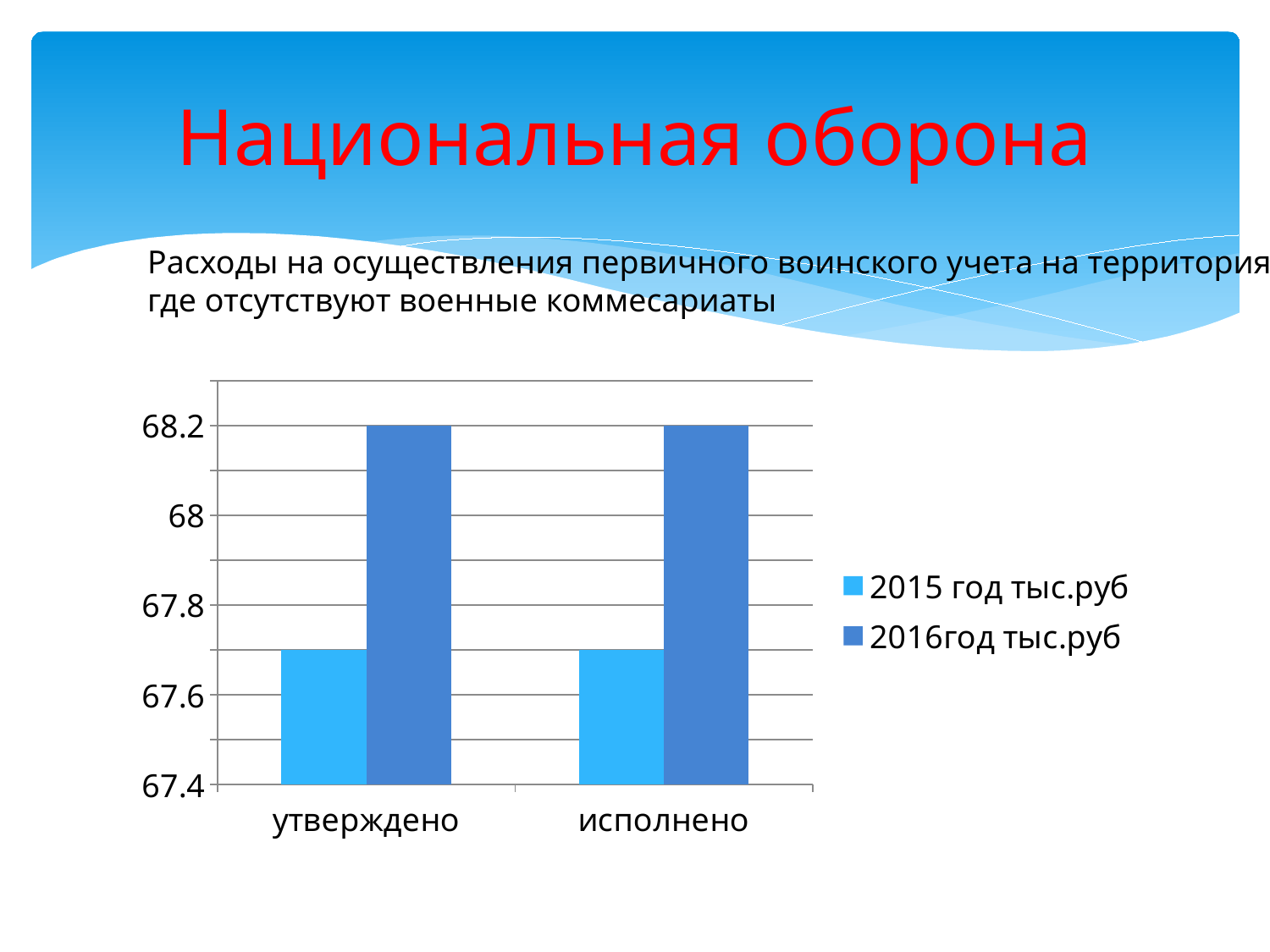
Do the values for 2016год тыс.руб rise, fall or stay the same from утверждено to исполнено? stay the same How many series does the chart legend list? 2 Which series has the lowest values in the chart? 2015 год тыс.руб What is the value for 2016год тыс.руб in the исполнено category? 68.2 Is the value for 2016год тыс.руб in the утверждено category greater or less than 68? greater Is the value for 2015 год тыс.руб in the исполнено category greater or less than 67.8? less What kind of chart is shown on the slide? bar chart In the утверждено category, which series has the larger value, 2015 год тыс.руб or 2016год тыс.руб? 2016год тыс.руб How many categories are shown on the x axis of the chart? 2 What is the value for 2016год тыс.руб in the утверждено category? 68.2 Is the value for 2015 год тыс.руб in the утверждено category greater or less than 67.6? greater What are the two entries listed in the chart legend? 2015 год тыс.руб and 2016год тыс.руб